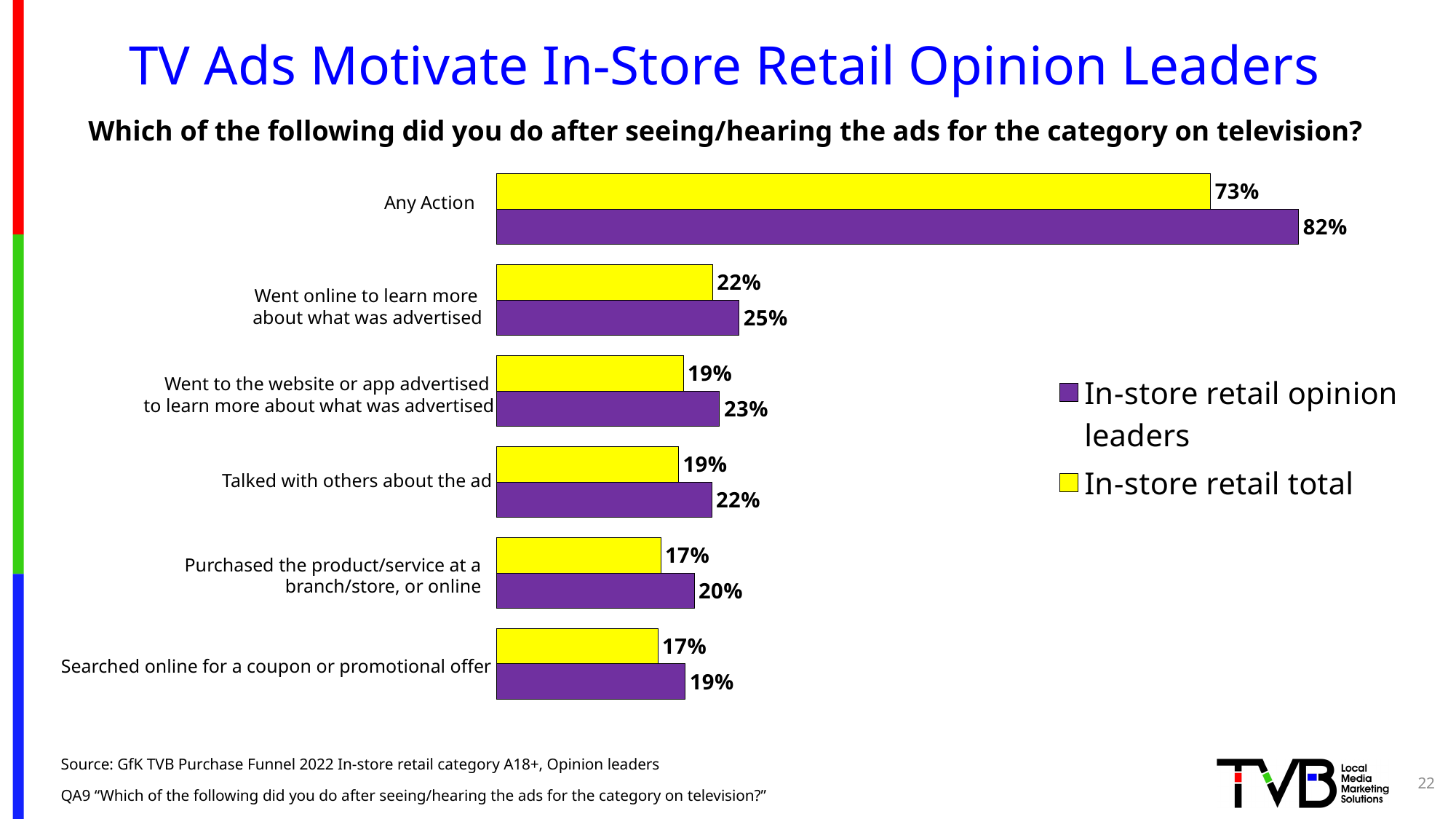
What percentage of in-store retail opinion leaders purchased the product/service at a branch/store, or online? 20% Which colour represents In-store retail total in the chart? Yellow How many series does the legend list? 2 What percentage of in-store retail opinion leaders took any action after seeing/hearing the ads? 82% How many categories are shown on the chart? 6 What is the difference between In-store retail opinion leaders and In-store retail total for 'Went to the website or app advertised to learn more about what was advertised'? 4% Which category has the highest value for In-store retail opinion leaders? Any Action What is the value for In-store retail total for 'Went online to learn more about what was advertised'? 22% Which category has the lowest value for In-store retail opinion leaders? Searched online for a coupon or promotional offer What kind of chart is shown on the slide? Bar chart What is the difference between In-store retail opinion leaders and In-store retail total for 'Any Action'? 9% For 'Talked with others about the ad', which series has the larger value: In-store retail opinion leaders or In-store retail total? In-store retail opinion leaders